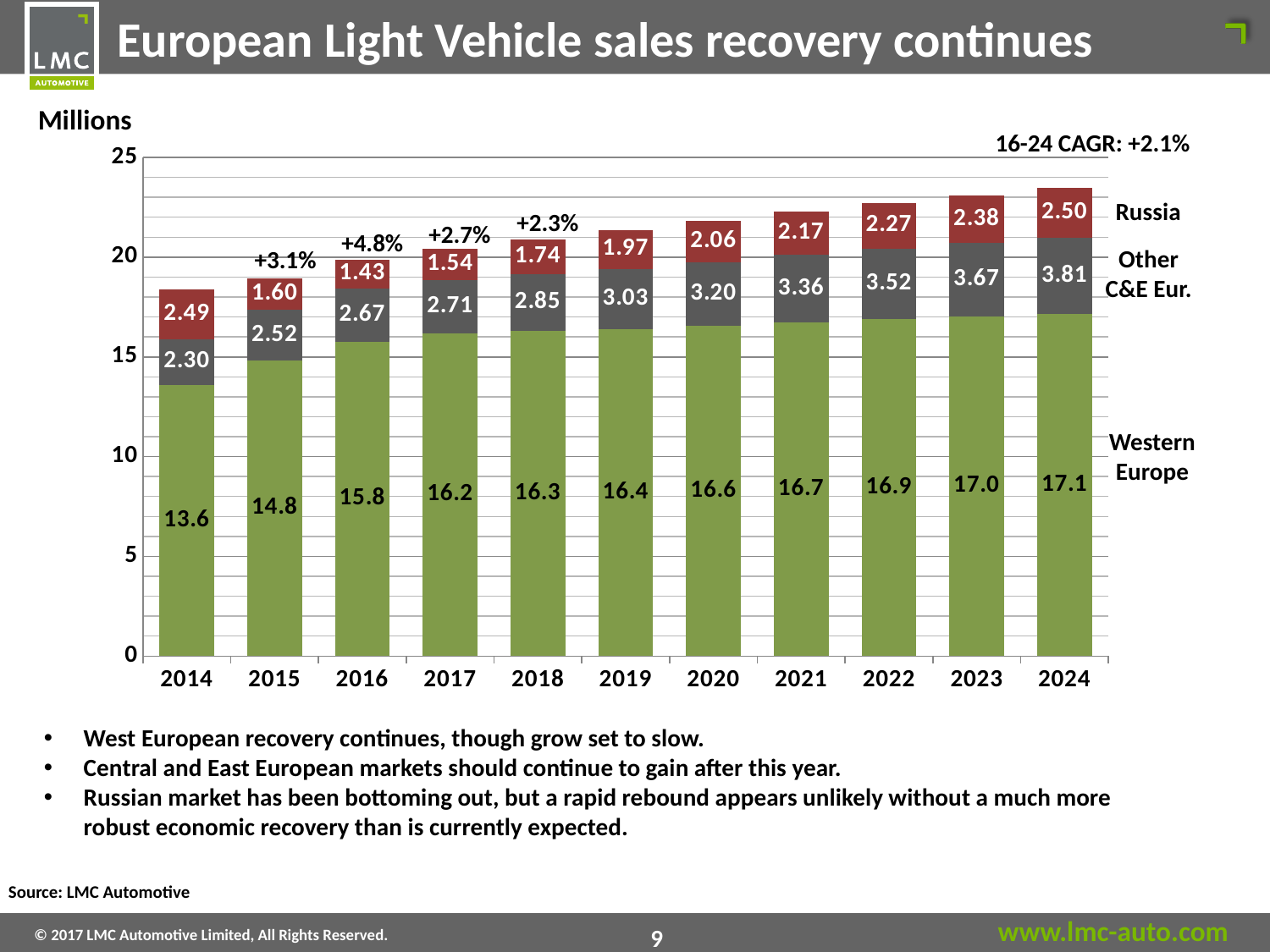
How many series does the chart show? 3 What kind of chart is shown on the slide? Stacked bar chart In which year is the Russia value lowest? 2016 Does the Western Europe value rise or fall from 2014 to 2024? Rise What is the Other C&E Eur. value for 2019? 3.03 Which is larger in 2014, the Russia value or the Other C&E Eur. value? Russia How many years are shown on the x axis? 11 What is the Western Europe value for 2014? 13.6 In which year is the Western Europe value highest? 2024 What is the Russia value for 2024? 2.50 What is the 16-24 CAGR shown on the chart? +2.1% What is the difference between the Western Europe values for 2024 and 2014? 3.5